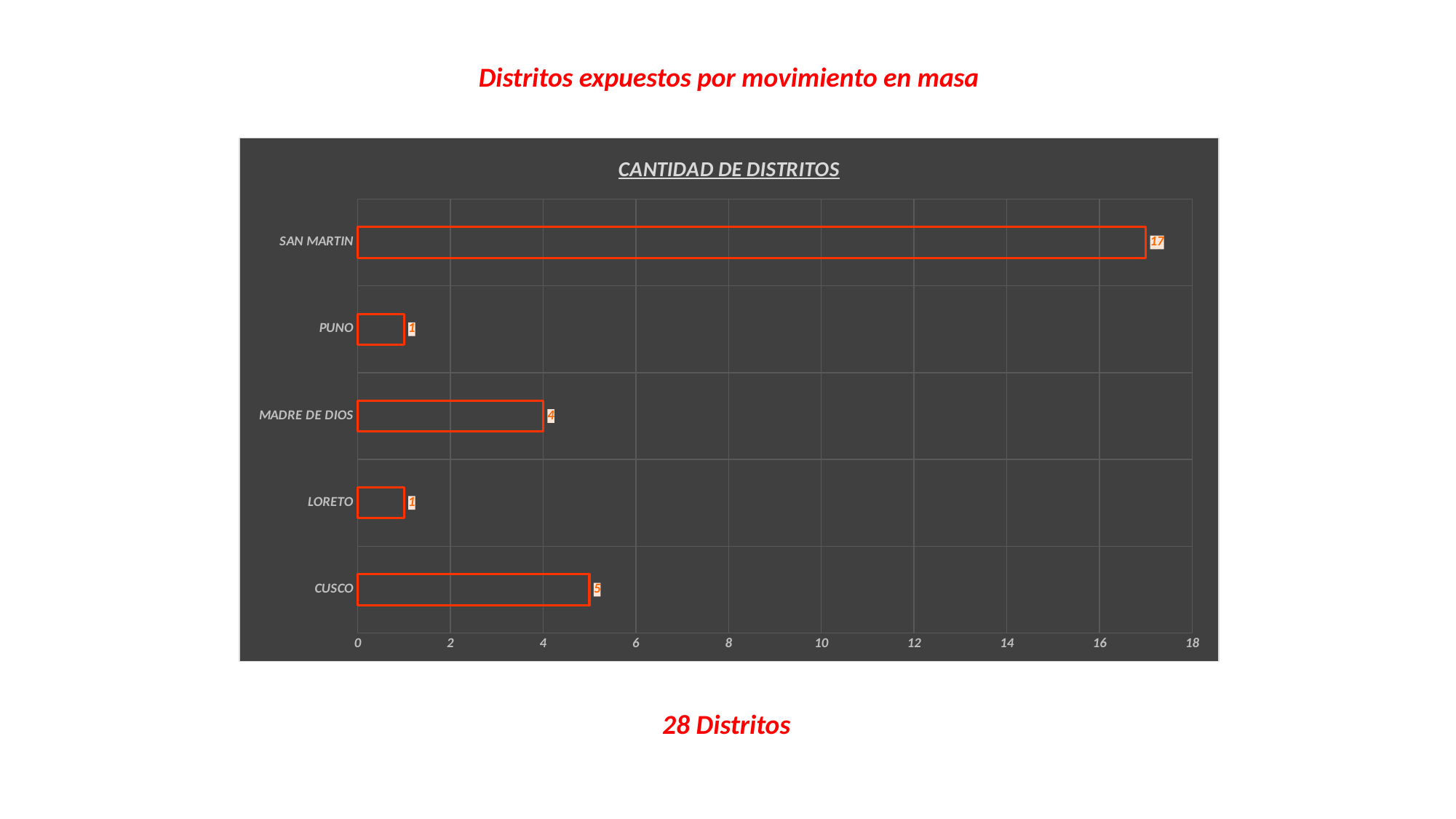
What is the title of the chart? CANTIDAD DE DISTRITOS Is the value for SAN MARTIN greater or less than 16? greater What is the value for SAN MARTIN? 17 What is the difference between the values for CUSCO and MADRE DE DIOS? 1 Which category has the highest value? SAN MARTIN What is the value for CUSCO? 5 What kind of chart is shown on the slide? bar chart What is the value for PUNO? 1 What is the difference between the values for SAN MARTIN and CUSCO? 12 How many categories are shown in the chart? 5 Which is larger, the value for CUSCO or the value for MADRE DE DIOS? CUSCO What is the value for MADRE DE DIOS? 4